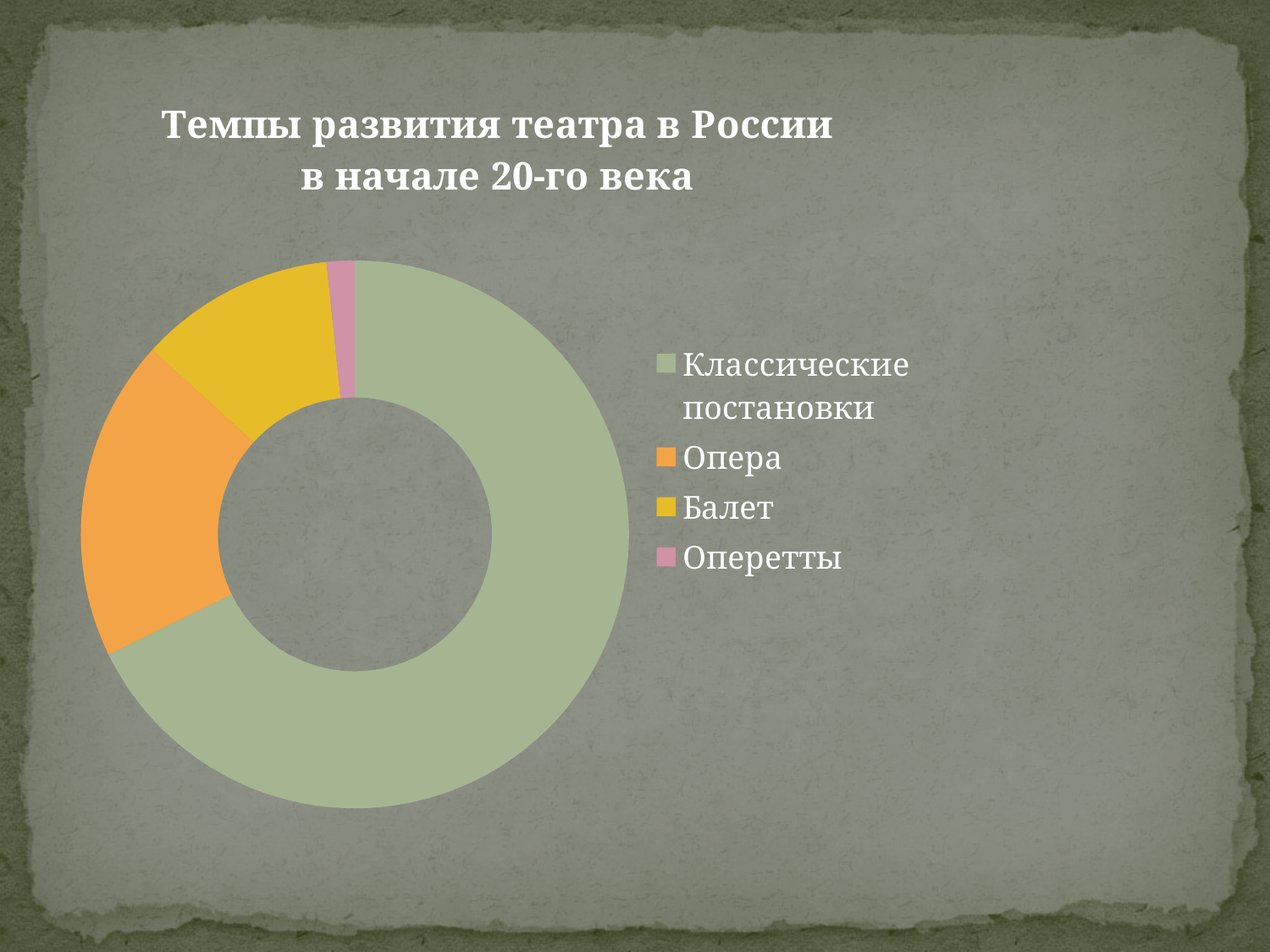
What is the title of the chart? Темпы развития театра в России в начале 20-го века Which slice is larger, Опера or Балет? Опера How many categories does the chart show? 4 Which category has the smallest slice? Оперетты Which slice is larger, Классические постановки or Опера? Классические постановки What colour is the Балет slice? yellow Which slice is larger, Балет or Оперетты? Балет How many entries does the legend list? 4 Which category has the largest slice? Классические постановки What kind of chart is shown on the slide? doughnut chart